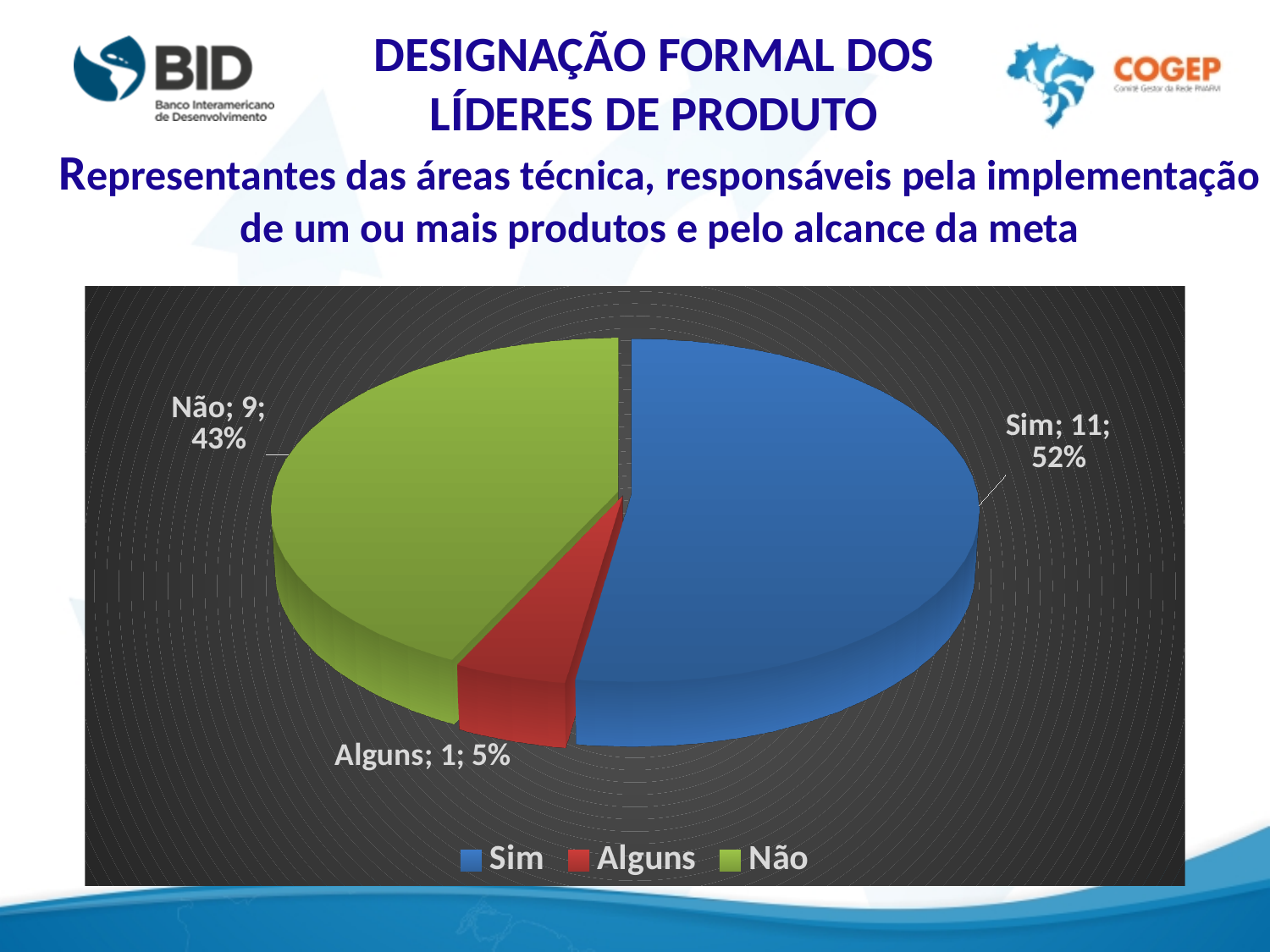
What share of the pie does 'Alguns' represent? 5% What is the count for the 'Sim' slice? 11 Which category has the largest slice? Sim What is the difference in count between 'Sim' and 'Não'? 2 How many slices does the pie chart have? 3 Which colour represents 'Não' in the legend? green What is the count for the 'Alguns' slice? 1 What is the count for the 'Não' slice? 9 What share of the pie does 'Não' represent? 43% What kind of chart is shown on the slide? pie chart Which category has the smallest slice? Alguns What share of the pie does 'Sim' represent? 52%